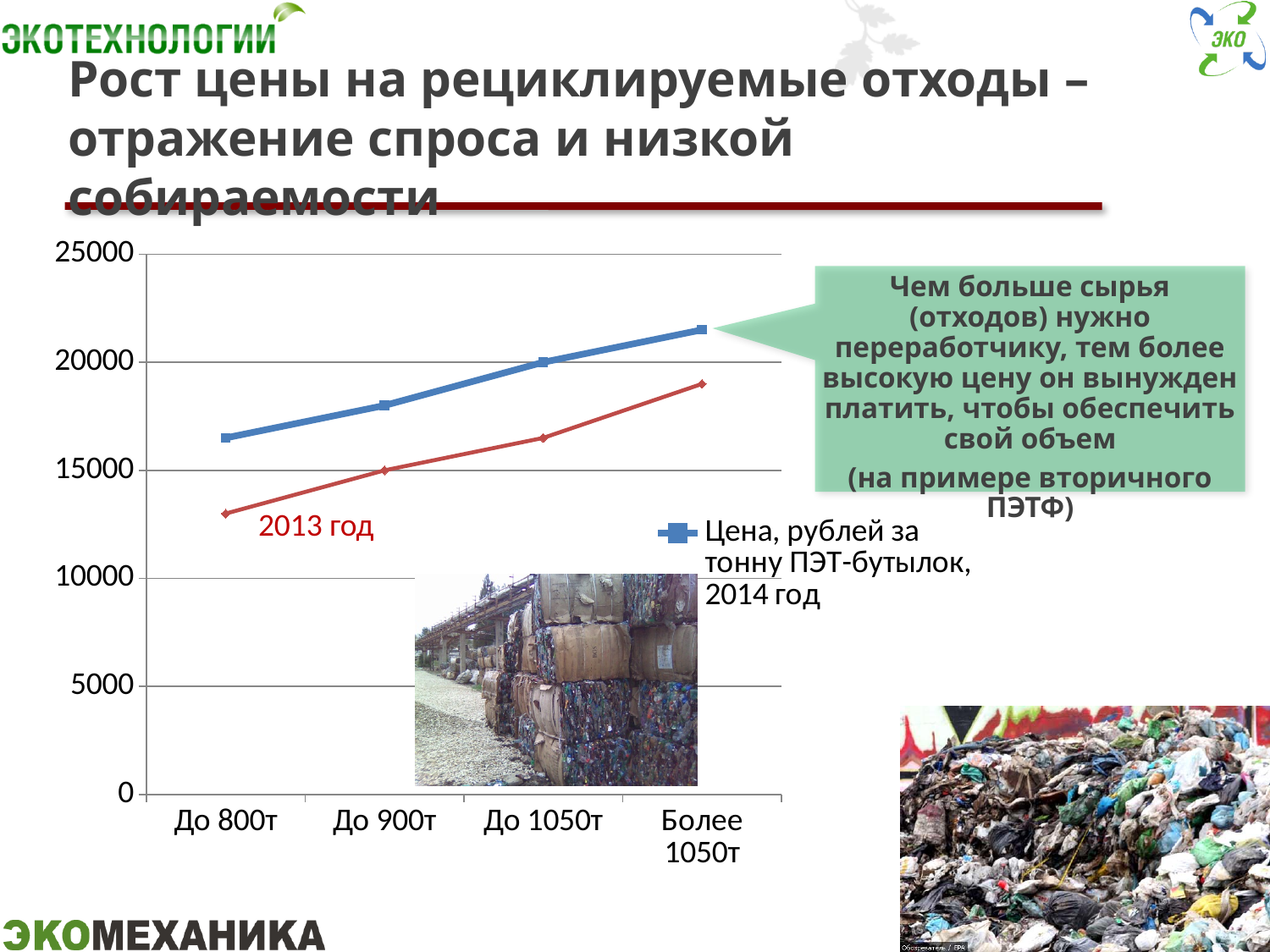
Is the 2014 value for 'До 800т' greater or less than 15000? greater How many categories are shown on the x axis of the chart? 4 Which category has the highest value on the 2014 line? Более 1050т Is the 2014 value for 'Более 1050т' greater or less than 20000? greater Is the 2013 value for 'До 800т' greater or less than 15000? less Does the 2014 price line rise or fall from 'До 800т' to 'Более 1050т'? rise Does the 2013 price line rise or fall along the x axis? rise Which category has the lowest value on the 2013 line? До 800т At 'До 800т', which line is higher: the 2014 line or the 2013 line? 2014 How many lines are plotted on the chart? 2 What kind of chart is shown on the slide? line chart